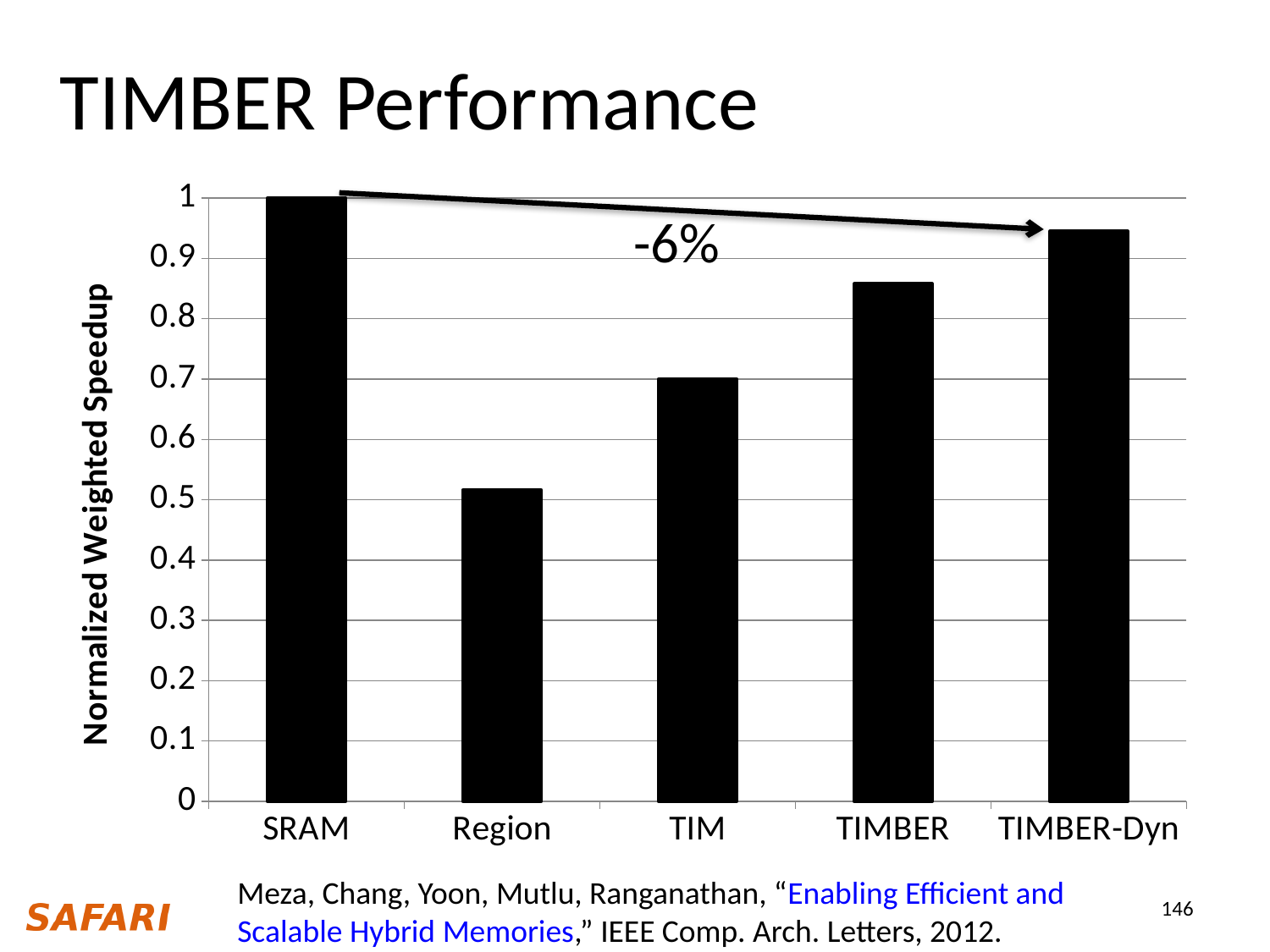
How many categories are shown on the x axis of the chart? 5 Which category has the lowest normalized weighted speedup? Region Is the value for TIM greater or less than 0.6? greater Is the value for TIMBER-Dyn greater or less than 0.9? greater Which has a higher normalized weighted speedup, TIM or TIMBER? TIMBER Is the value for TIMBER greater or less than 0.8? greater Which category has the highest normalized weighted speedup? SRAM What is the label on the y axis of the chart? Normalized Weighted Speedup What kind of chart is shown on the slide? bar chart Which has a higher normalized weighted speedup, TIMBER or TIMBER-Dyn? TIMBER-Dyn What is the normalized weighted speedup for SRAM? 1